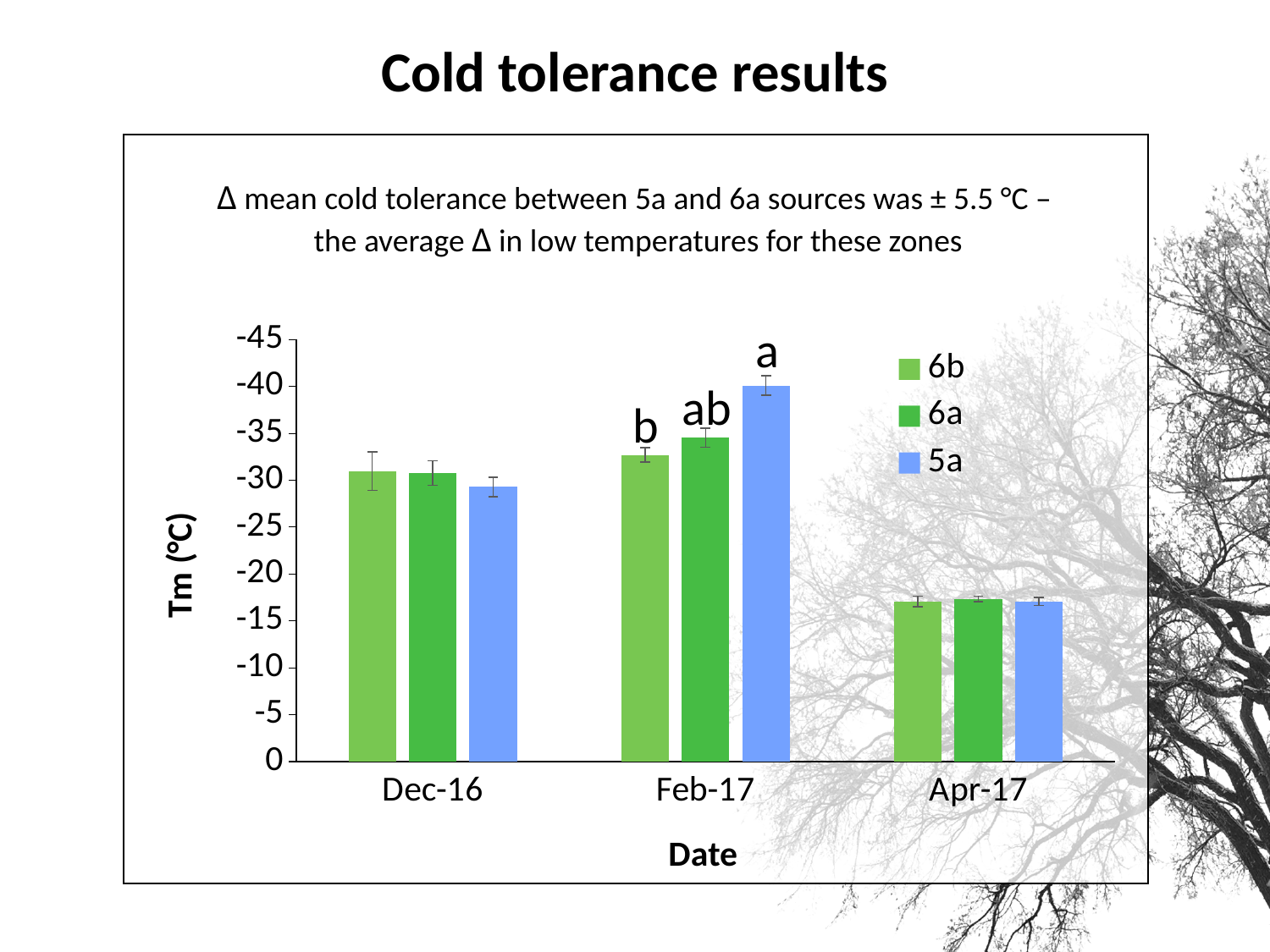
What is the label on the y axis of the chart? Tm (°C) Is the Tm value for 5a at Feb-17 greater or less than -35? less At which date are the Tm values for all three series closest to 0? Apr-17 How many dates are shown on the x axis of the chart? 3 Is the Tm value for 6b at Apr-17 greater or less than -20? greater How many series does the chart legend list? 3 What letter is printed above the 5a bar at Feb-17? a What kind of chart is shown on the slide? bar chart Which series has the most negative Tm value at Feb-17? 5a Which is more negative: the Tm value for 5a at Feb-17 or for 5a at Dec-16? 5a at Feb-17 At which date does the 5a series reach its most negative Tm value? Feb-17 Is the Tm value for 6a at Dec-16 greater or less than -35? greater